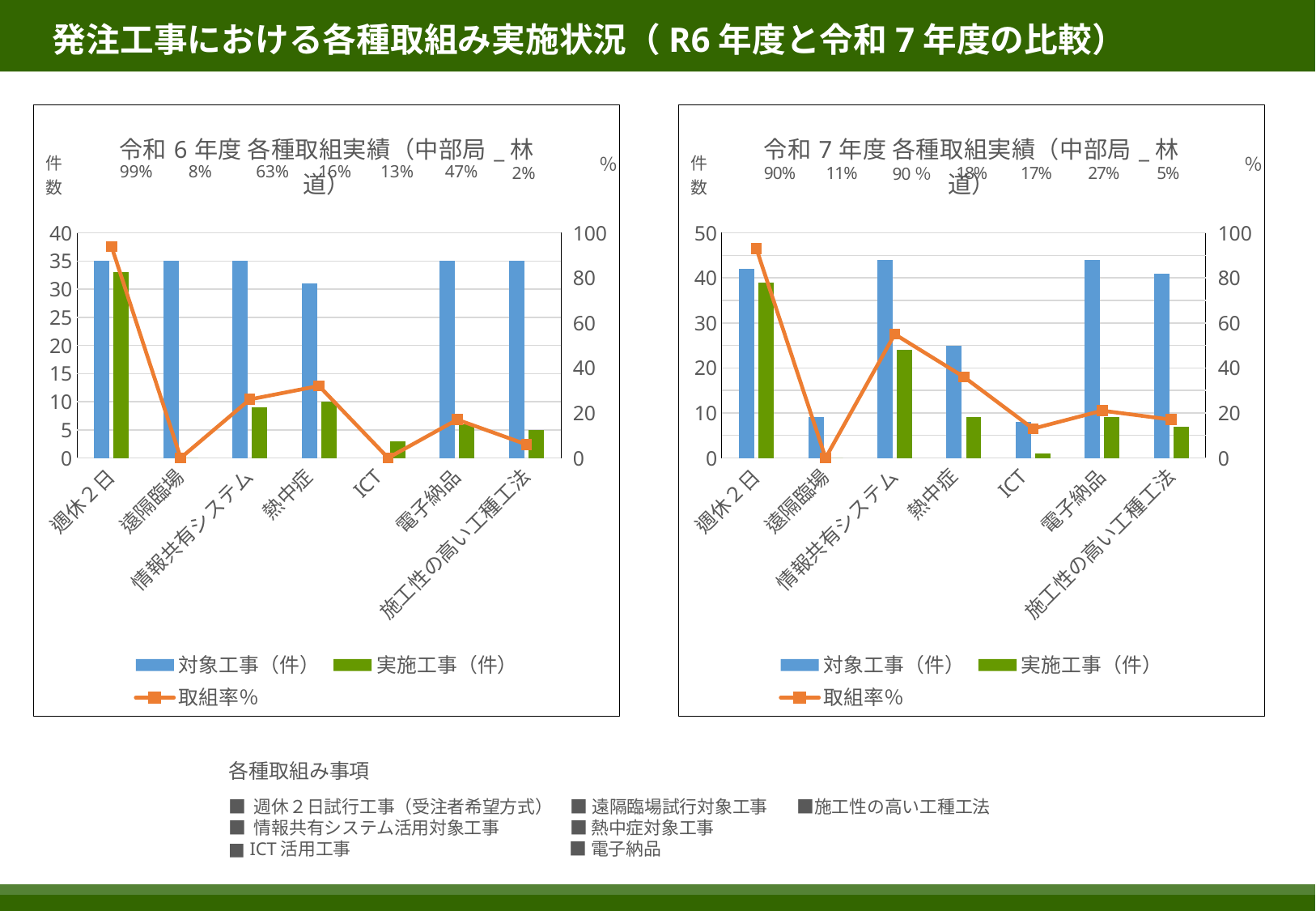
What kind of chart is the left chart (令和6年度 各種取組実績)? Bar chart with a line In the right chart (令和7年度 各種取組実績), does the 取組率% line rise or fall from 週休2日 to 遠隔臨場? fall In the right chart (令和7年度 各種取組実績), is the 実施工事（件） value for 情報共有システム greater or less than 30? less In the right chart (令和7年度 各種取組実績), is the 対象工事（件） value for 遠隔臨場 greater or less than 20? less In the left chart (令和6年度 各種取組実績), what is the 実施工事（件） value for 施工性の高い工種工法? 5 In the right chart (令和7年度 各種取組実績), which category has the highest 実施工事（件） value? 週休2日 In the left chart (令和6年度 各種取組実績), what is the 実施工事（件） value for 熱中症? 10 In the left chart (令和6年度 各種取組実績), is the 実施工事（件） value for 週休2日 greater or less than 30? greater How many categories are shown on the x axis of the right chart (令和7年度 各種取組実績)? 7 In the left chart (令和6年度 各種取組実績), what is the 対象工事（件） value for 週休2日? 35 In the left chart (令和6年度 各種取組実績), which is larger for 実施工事（件）: 週休2日 or 熱中症? 週休2日 How many series does the legend of the left chart (令和6年度 各種取組実績) list? 3